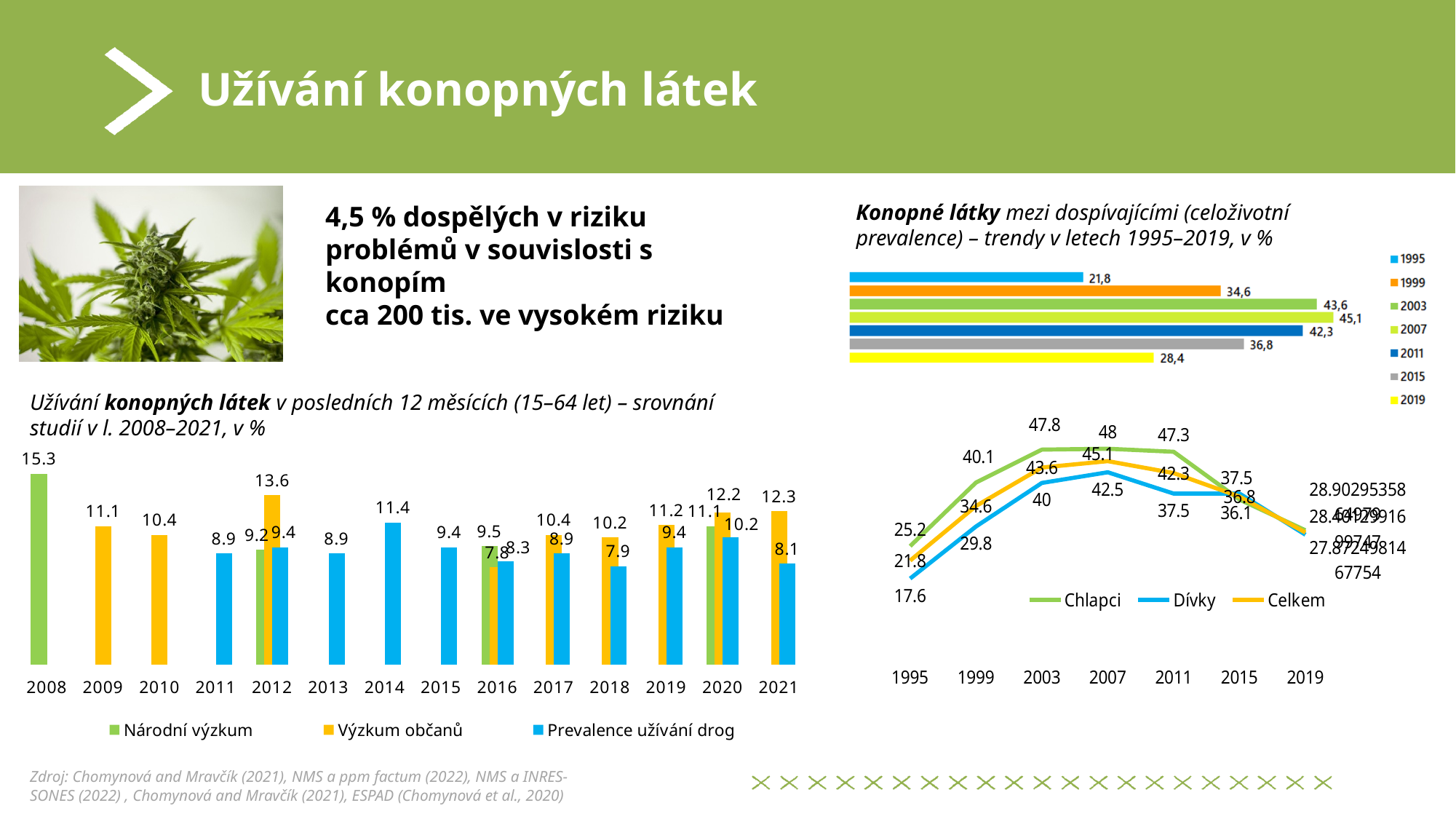
In the top-right horizontal bar chart (Konopné látky mezi dospívajícími), which year has the lowest value? 1995 In the bottom-left bar chart (Užívání konopných látek v posledních 12 měsících), how many years are shown on the x axis? 14 In the bottom-right line chart, which series has the highest value in 2003? Chlapci In the bottom-left bar chart (Užívání konopných látek v posledních 12 měsících), what is the difference between Výzkum občanů and Prevalence užívání drog in 2021? 4.2 In the bottom-left bar chart (Užívání konopných látek v posledních 12 měsících), what is the value for Výzkum občanů in 2012? 13.6 In the bottom-left bar chart (Užívání konopných látek v posledních 12 měsících), how many series does the legend list? 3 In the top-right horizontal bar chart (Konopné látky mezi dospívajícími), what is the value for 2007? 45,1 In the bottom-left bar chart (Užívání konopných látek v posledních 12 měsících), which is larger in 2020: Národní výzkum or Výzkum občanů? Výzkum občanů In the top-right horizontal bar chart (Konopné látky mezi dospívajícími), how many years does the legend list? 7 In the bottom-left bar chart (Užívání konopných látek v posledních 12 měsících), what is the value for Prevalence užívání drog in 2014? 11.4 In the bottom-left bar chart (Užívání konopných látek v posledních 12 měsících), what is the value for Národní výzkum in 2008? 15.3 In the bottom-right line chart, what is the value for Dívky in 2007? 42.5